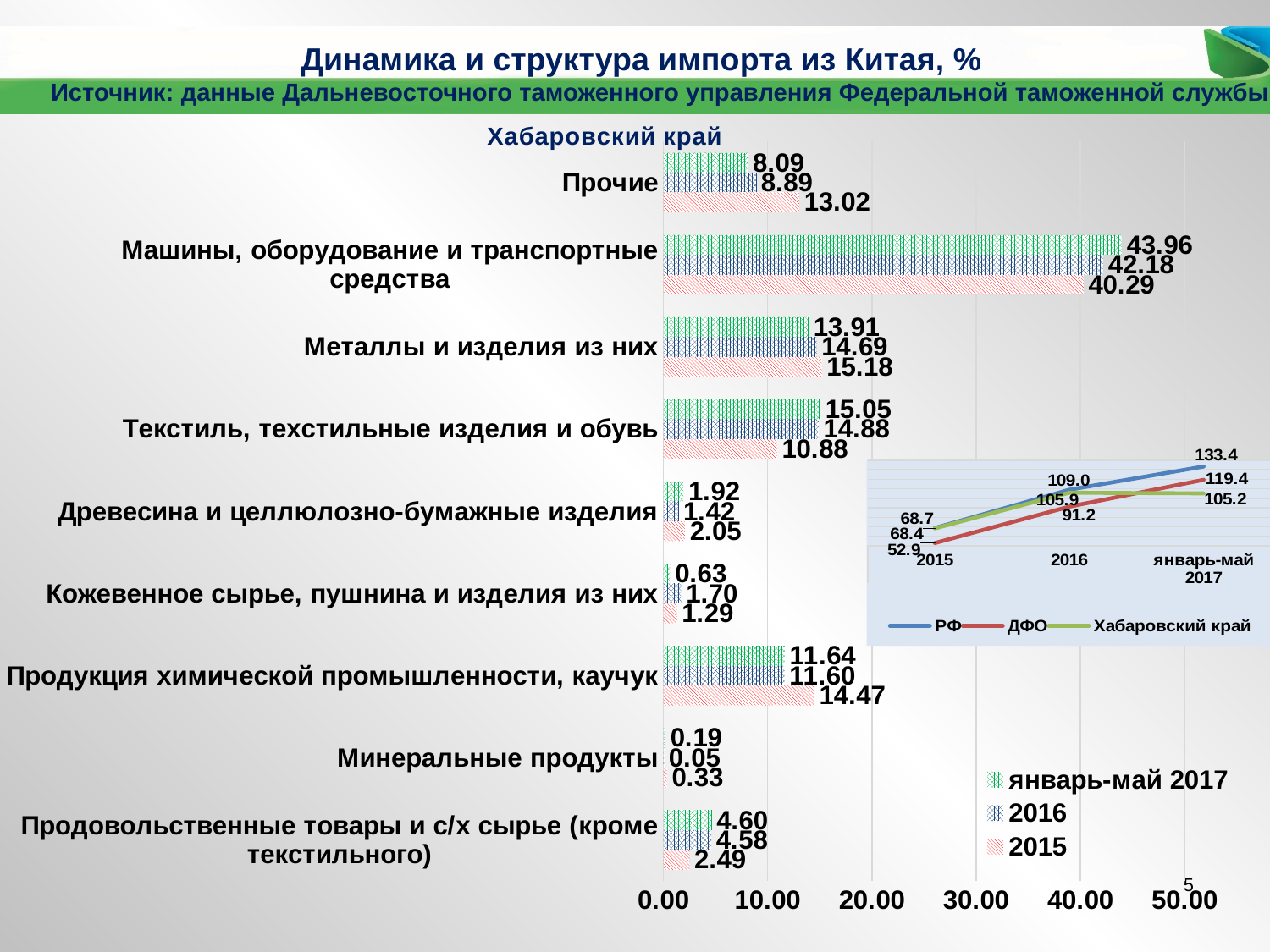
In the bar chart 'Хабаровский край', which category has the lowest value in январь-май 2017? Минеральные продукты What type of chart is the large chart titled 'Хабаровский край'? Bar chart In the bar chart 'Хабаровский край', how many series does the legend list? 3 In the line chart inset, which series has the lowest value in 2015? ДФО In the bar chart 'Хабаровский край', which is larger for 'Металлы и изделия из них': the 2015 value or the 2016 value? 2015 In the bar chart 'Хабаровский край', how many product categories are shown? 9 In the line chart inset, what is the value for РФ in январь-май 2017? 133.4 In the bar chart 'Хабаровский край', what is the difference between the 2015 and январь-май 2017 values for 'Текстиль, техстильные изделия и обувь'? 4.17 In the bar chart 'Хабаровский край', what is the 2015 value for 'Прочие'? 13.02 In the line chart inset, does the value for ДФО rise or fall from 2015 to январь-май 2017? Rise In the bar chart 'Хабаровский край', which category has the highest value in 2016? Машины, оборудование и транспортные средства In the bar chart 'Хабаровский край', what is the value for 'Машины, оборудование и транспортные средства' in январь-май 2017? 43.96